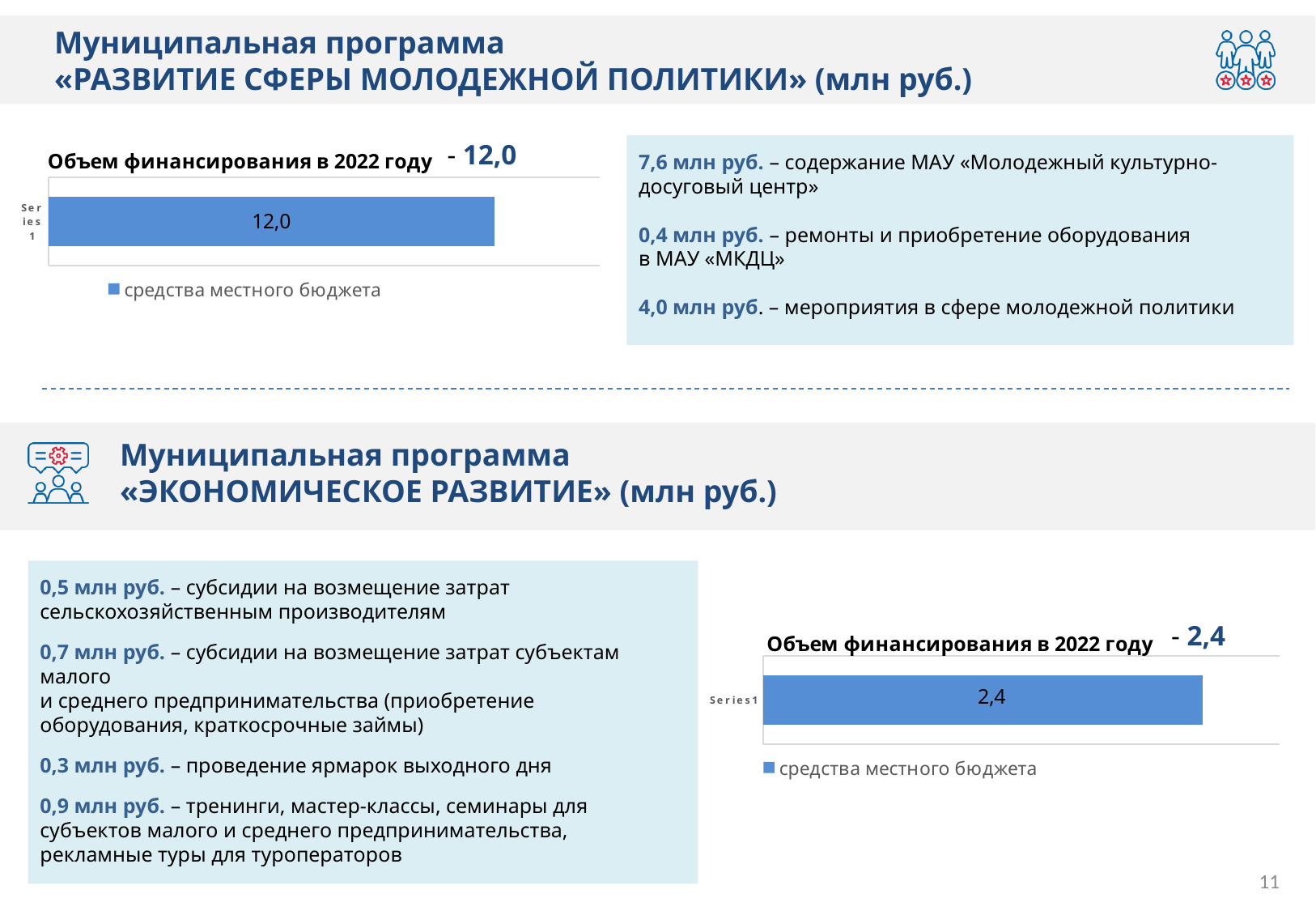
What legend entry is shown under the bottom chart? средства местного бюджета What is the title of the top chart? Объем финансирования в 2022 году In the top chart (Объем финансирования в 2022 году, youth policy programme), what value is printed on the bar? 12,0 How many bars does the top chart show? 1 What is the difference between the value in the top chart (12,0) and the value in the bottom chart (2,4)? 9,6 How many series does the legend of the top chart list? 1 What kind of chart is the top chart on the slide? bar chart How many bars does the bottom chart show? 1 Which chart shows the larger funding value, the top chart (youth policy) or the bottom chart (economic development)? the top chart In the bottom chart (Объем финансирования в 2022 году, economic development programme), what value is printed on the bar? 2,4 What kind of chart is the bottom chart on the slide? bar chart